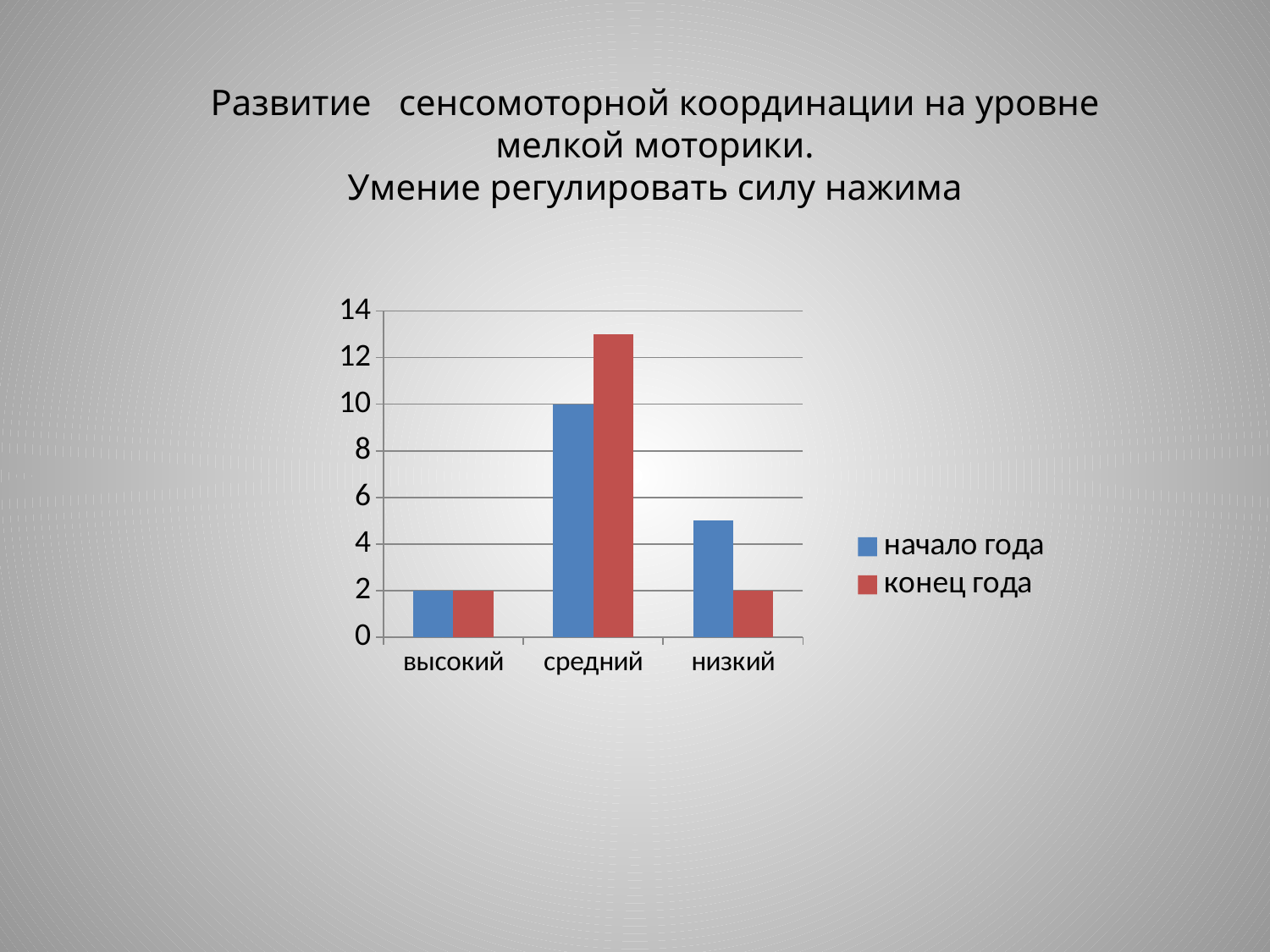
Is the value for "конец года" in the "средний" category greater or less than 12? greater Is the value for "начало года" in the "низкий" category greater or less than 4? greater Which category has the highest value for "начало года"? средний Which category has the lowest value for "начало года"? высокий What is the value for "конец года" in the "низкий" category? 2 How many series does the legend list? 2 How many categories are shown on the x axis? 3 What is the value for "конец года" in the "высокий" category? 2 What is the value for "начало года" in the "средний" category? 10 What is the difference between the "начало года" values for "средний" and "высокий"? 8 What kind of chart is shown on the slide? bar chart In the "средний" category, which is larger: "начало года" or "конец года"? конец года